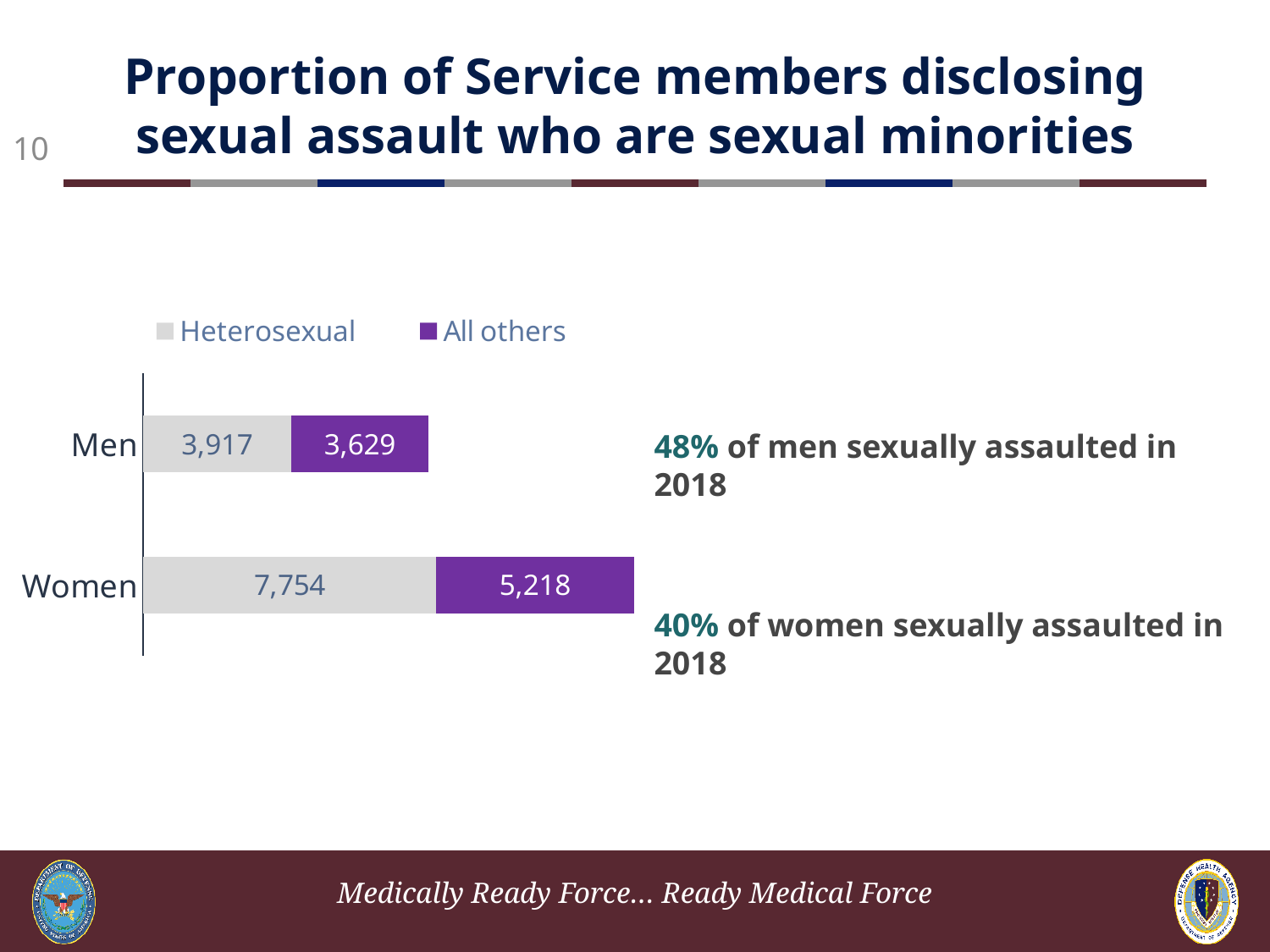
What is the difference between the Heterosexual values for Women and Men? 3,837 What kind of chart is shown on the slide? Stacked bar chart Which colour represents the All others series? Purple How many categories are shown on the chart? 2 Which category has the larger All others value, Men or Women? Women What is the total of the stacked bar for Men? 7,546 What is the Heterosexual value for Women? 7,754 What is the All others value for Women? 5,218 What is the All others value for Men? 3,629 What is the Heterosexual value for Men? 3,917 How many series does the legend list? 2 What is the total of the stacked bar for Women? 12,972